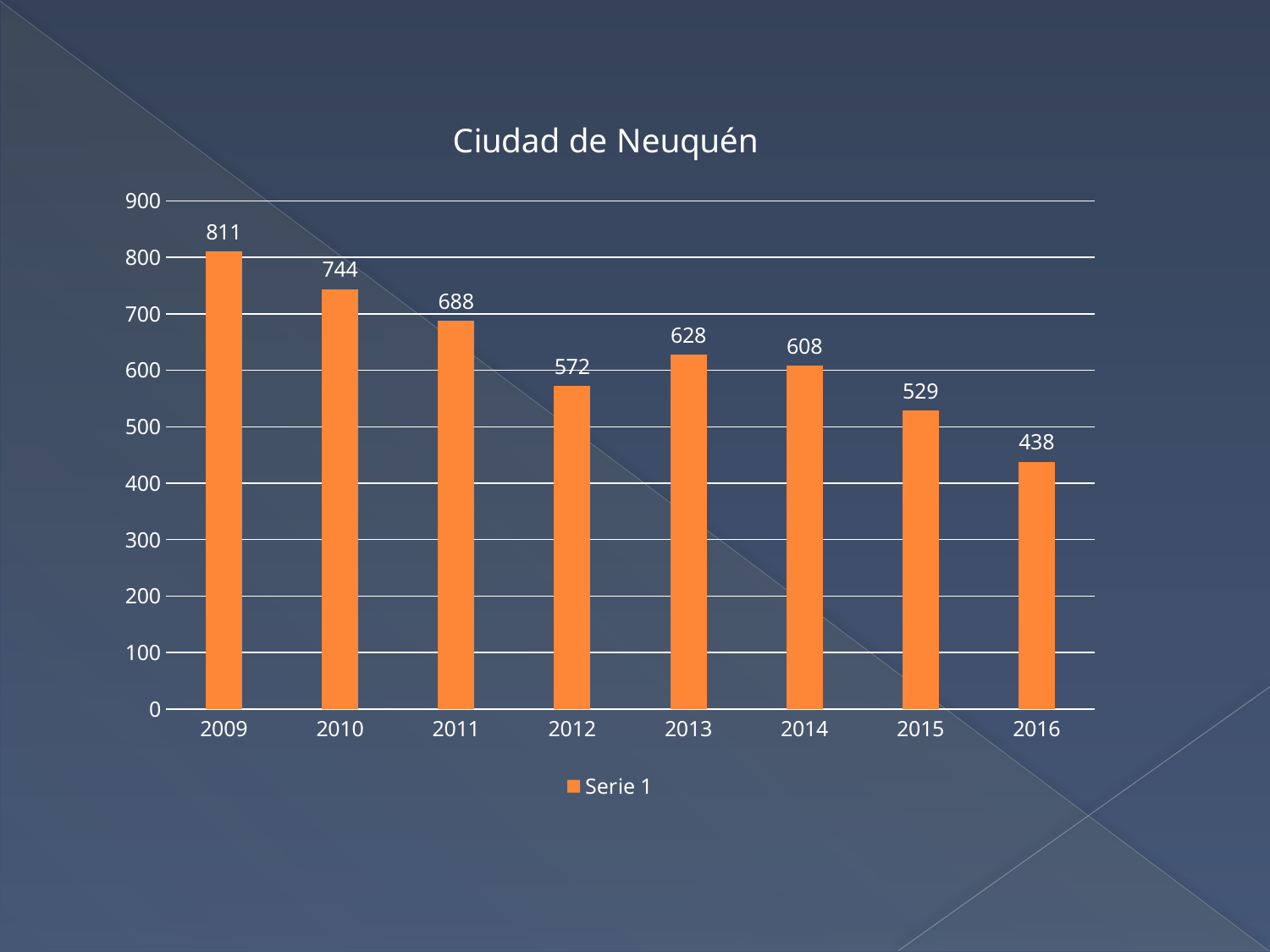
What is the difference between the values for 2012 and 2013? 56 Which year has the lowest value? 2016 What is the value for 2009? 811 Is the value for 2015 greater or less than 600? less How many years are shown on the x axis? 8 What is the title of the chart? Ciudad de Neuquén What is the difference between the values for 2009 and 2016? 373 Which year has the highest value? 2009 What is the value for 2016? 438 What kind of chart is this? bar chart Which is larger, the value for 2010 or the value for 2014? 2010 What is the value for 2013? 628